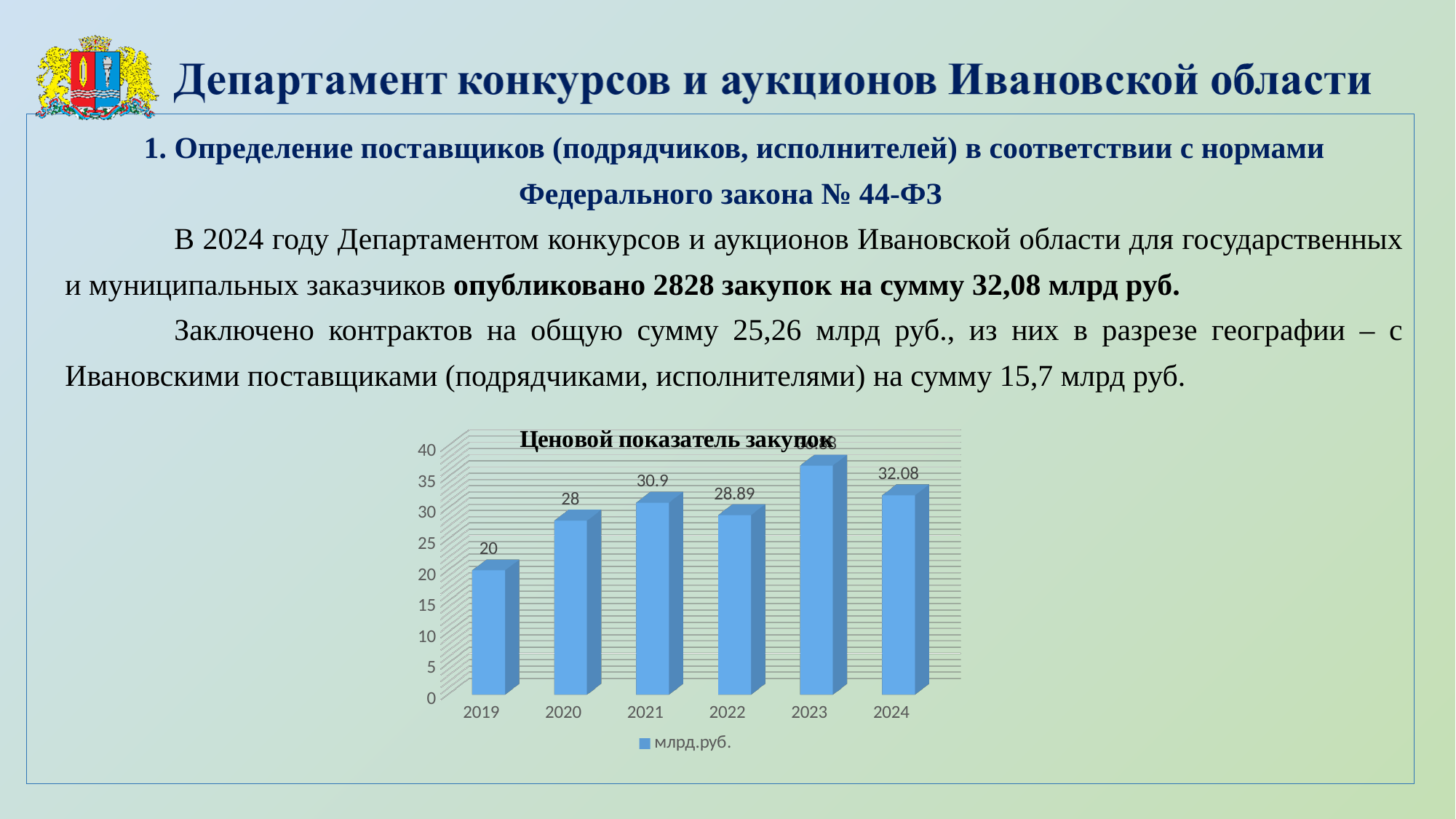
What is the value for 2024 in the chart "Ценовой показатель закупок"? 32.08 Is the value for 2023 in the chart "Ценовой показатель закупок" greater or less than 35? greater How many years are shown on the x axis of the chart "Ценовой показатель закупок"? 6 How many series does the legend of the chart "Ценовой показатель закупок" list? 1 What is the value for 2021 in the chart "Ценовой показатель закупок"? 30.9 Which year has the highest value in the chart "Ценовой показатель закупок"? 2023 Which year has the lowest value in the chart "Ценовой показатель закупок"? 2019 What is the value for 2019 in the chart "Ценовой показатель закупок"? 20 What kind of chart is "Ценовой показатель закупок"? bar chart Which is larger in the chart "Ценовой показатель закупок": the value for 2021 or the value for 2022? 2021 What is the difference between the values for 2024 and 2019 in the chart "Ценовой показатель закупок"? 12.08 What unit is given in the legend of the chart "Ценовой показатель закупок"? млрд.руб.